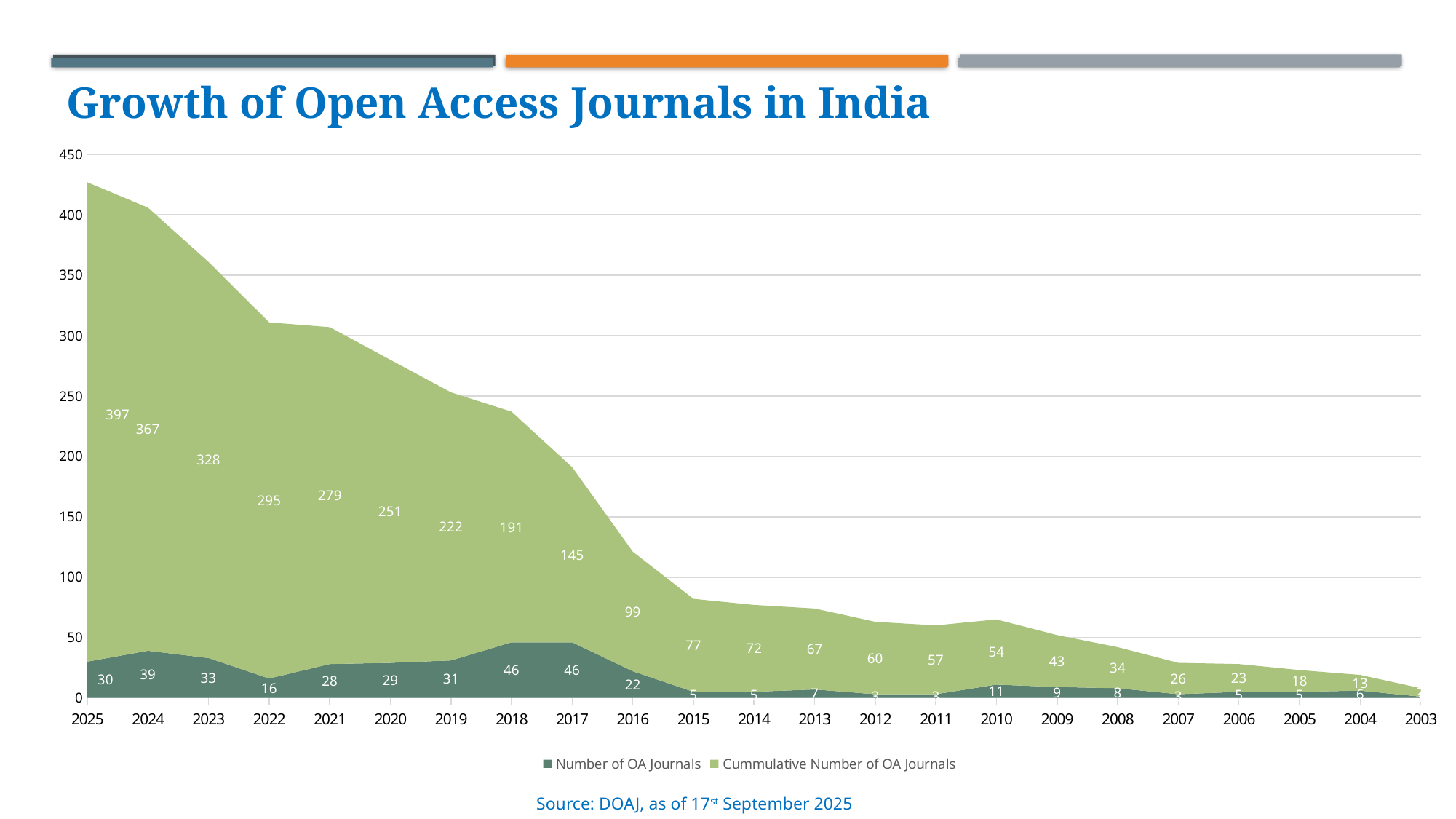
What is the title of the chart? Growth of Open Access Journals in India Which year has the lowest Number of OA Journals among 2025, 2024, 2023 and 2022? 2022 What kind of chart is shown on the slide? Area chart How many series does the legend list? 2 What is the Cummulative Number of OA Journals for 2016? 99 Which is larger, the Number of OA Journals in 2024 or in 2021? 2024 What is the Number of OA Journals for 2018? 46 What is the difference between the Cummulative Number of OA Journals in 2025 and 2024? 30 What is the Cummulative Number of OA Journals for 2025? 397 Which year has the highest Cummulative Number of OA Journals? 2025 What is the total of the two series for 2017 (Number of OA Journals plus Cummulative Number of OA Journals)? 191 What is the Number of OA Journals for 2022? 16